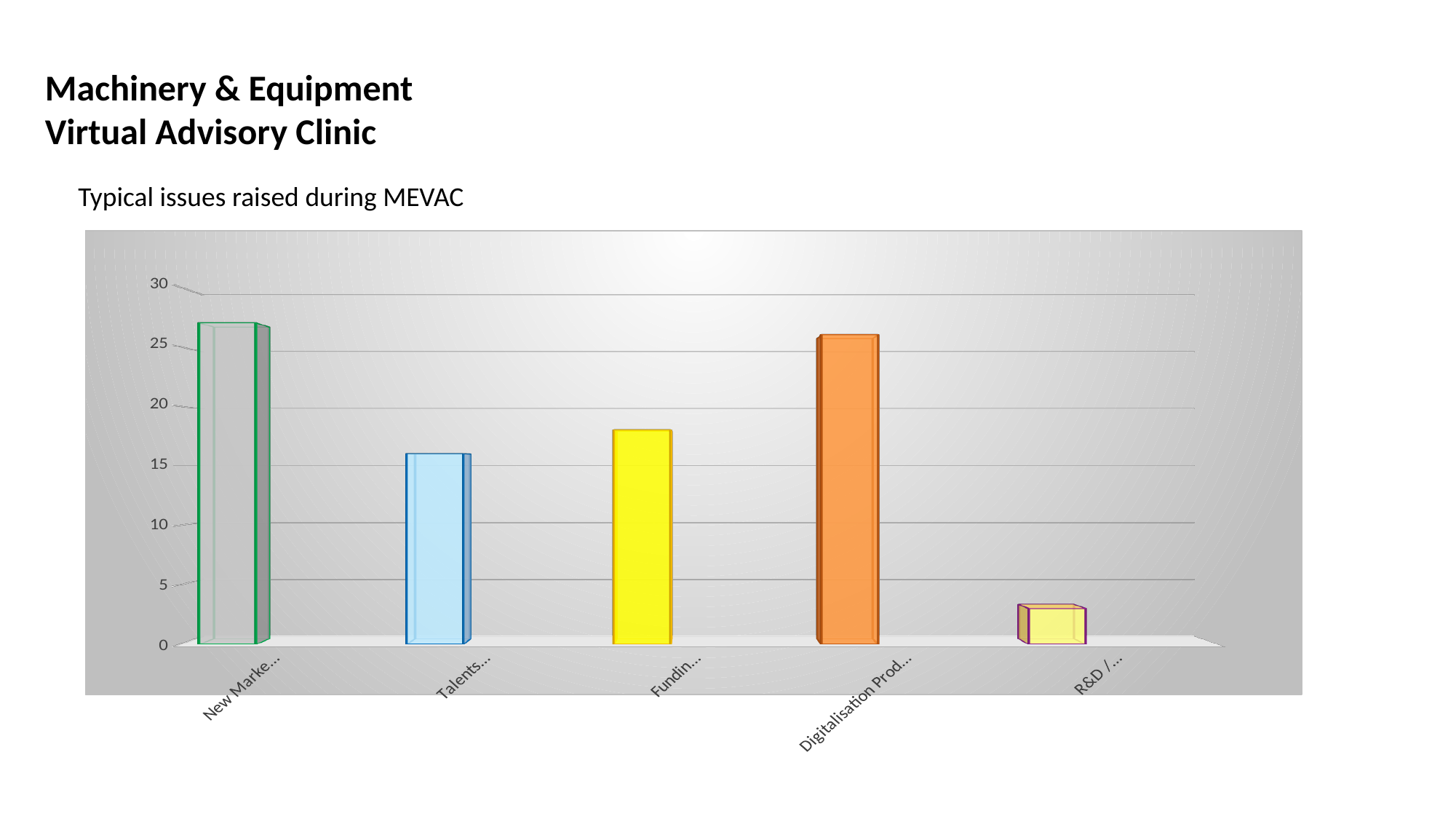
Is the value for the bar labelled 'Talents...' greater or less than 20? less Is the value for the bar labelled 'Digitalisation Prod...' greater or less than 20? greater How many bars does the chart show? 5 Is the value for the bar labelled 'R&D / ...' greater or less than 5? less What kind of chart is shown on the slide? bar chart What is the title shown above the chart? Typical issues raised during MEVAC What colour is the bar for 'Digitalisation Prod...'? orange Which is larger, the value for 'Digitalisation Prod...' or the value for 'Talents...'? Digitalisation Prod... Which is larger, the value for 'Fundin...' or the value for 'R&D / ...'? Fundin... Which category has the lowest bar in the chart? R&D / ...